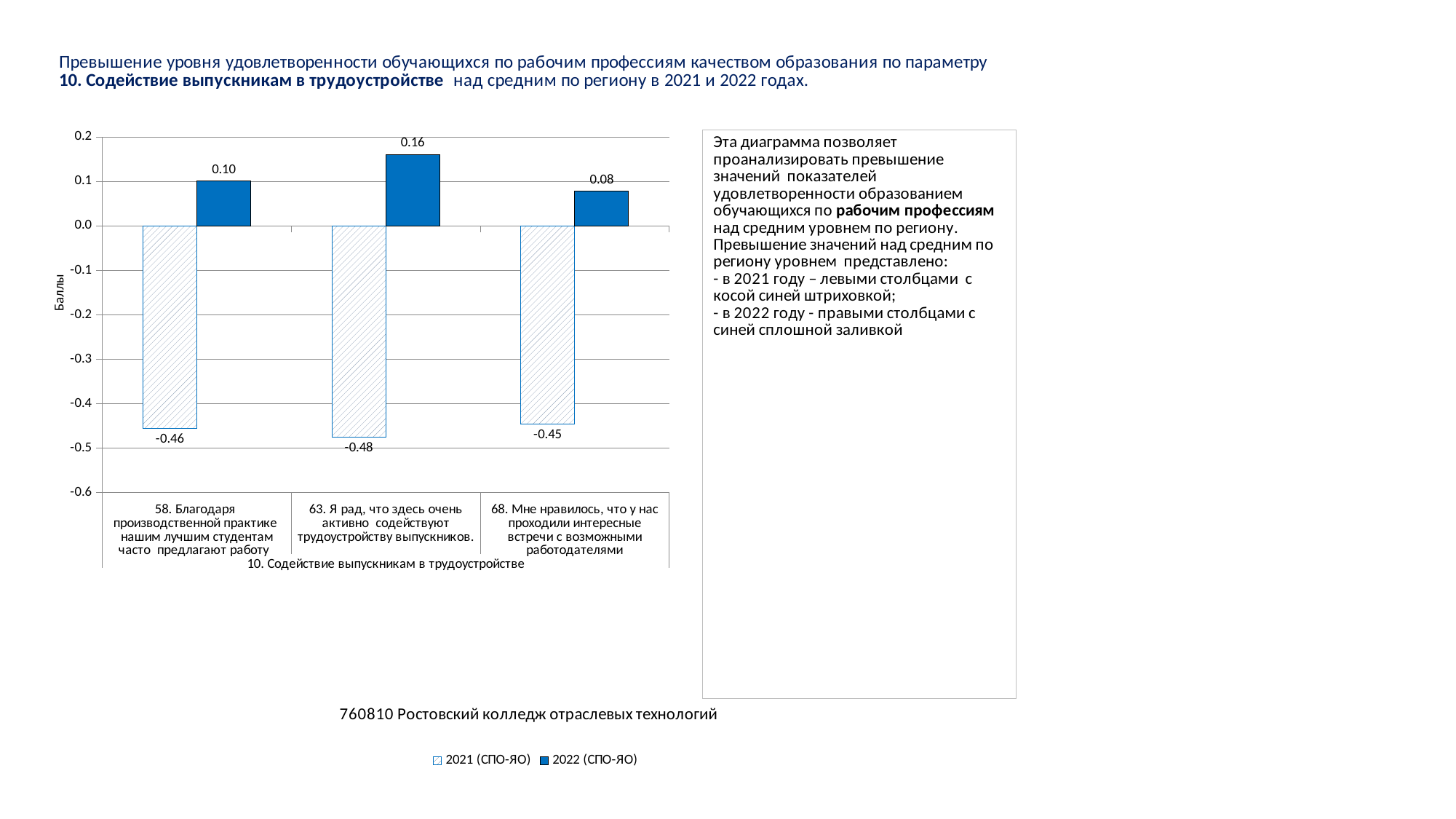
What is the value for 2021 (СПО-ЯО) for category "58. Благодаря производственной практике нашим лучшим студентам часто предлагают работу"? -0.46 What is the value for 2022 (СПО-ЯО) for category "63. Я рад, что здесь очень активно содействуют трудоустройству выпускников."? 0.16 What is the label of the vertical axis? Баллы How many series does the legend list? 2 What is the value for 2021 (СПО-ЯО) for category "68. Мне нравилось, что у нас проходили интересные встречи с возможными работодателями"? -0.45 Which category has the lowest value for the 2021 (СПО-ЯО) series? 63. Я рад, что здесь очень активно содействуют трудоустройству выпускников. What kind of chart is shown on the slide? bar chart Which category has the highest value for the 2022 (СПО-ЯО) series? 63. Я рад, что здесь очень активно содействуют трудоустройству выпускников. How many categories are shown on the x axis? 3 What is the value for 2022 (СПО-ЯО) for category "68. Мне нравилось, что у нас проходили интересные встречи с возможными работодателями"? 0.08 Which is larger: the 2022 (СПО-ЯО) value for category 58 or for category 68? category 58 What is the difference between the 2022 (СПО-ЯО) values for category 63 and category 68? 0.08